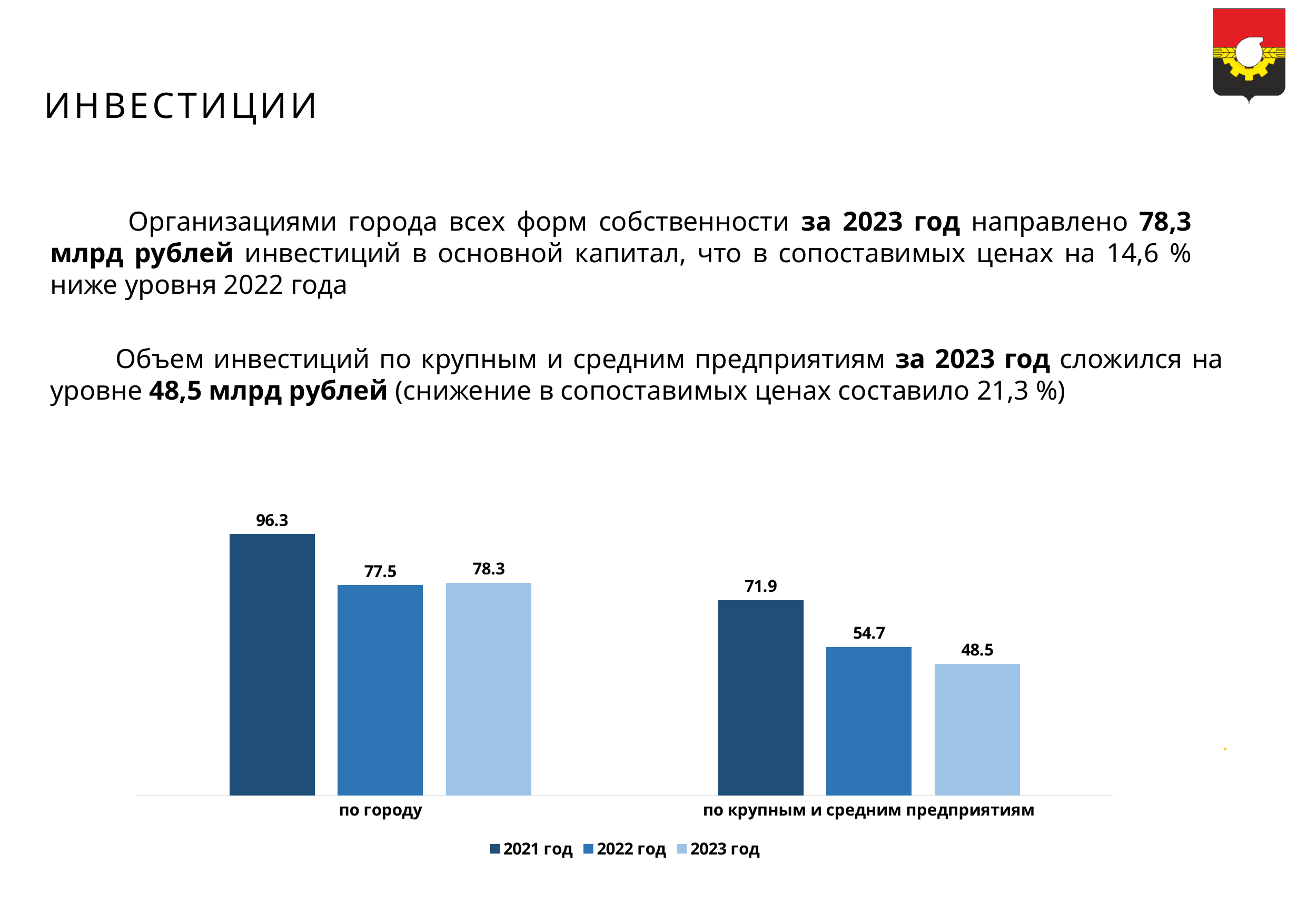
Which year has the highest value in the по крупным и средним предприятиям category? 2021 год What is the difference between the 2021 год and 2023 год values in the по городу category? 18 What kind of chart is shown on the slide? bar chart What is the value for 2021 год in the по городу category? 96.3 What is the value for 2022 год in the по городу category? 77.5 What is the difference between the 2022 год and 2023 год values in the по крупным и средним предприятиям category? 6.2 Which is larger: the 2023 год value for по городу or the 2021 год value for по крупным и средним предприятиям? по городу (2023 год) What is the value for 2023 год in the по крупным и средним предприятиям category? 48.5 How many categories are shown on the x axis? 2 How many series does the legend list? 3 Which year has the lowest value in the по городу category? 2022 год Do the values for по крупным и средним предприятиям rise or fall from 2021 год to 2023 год? fall